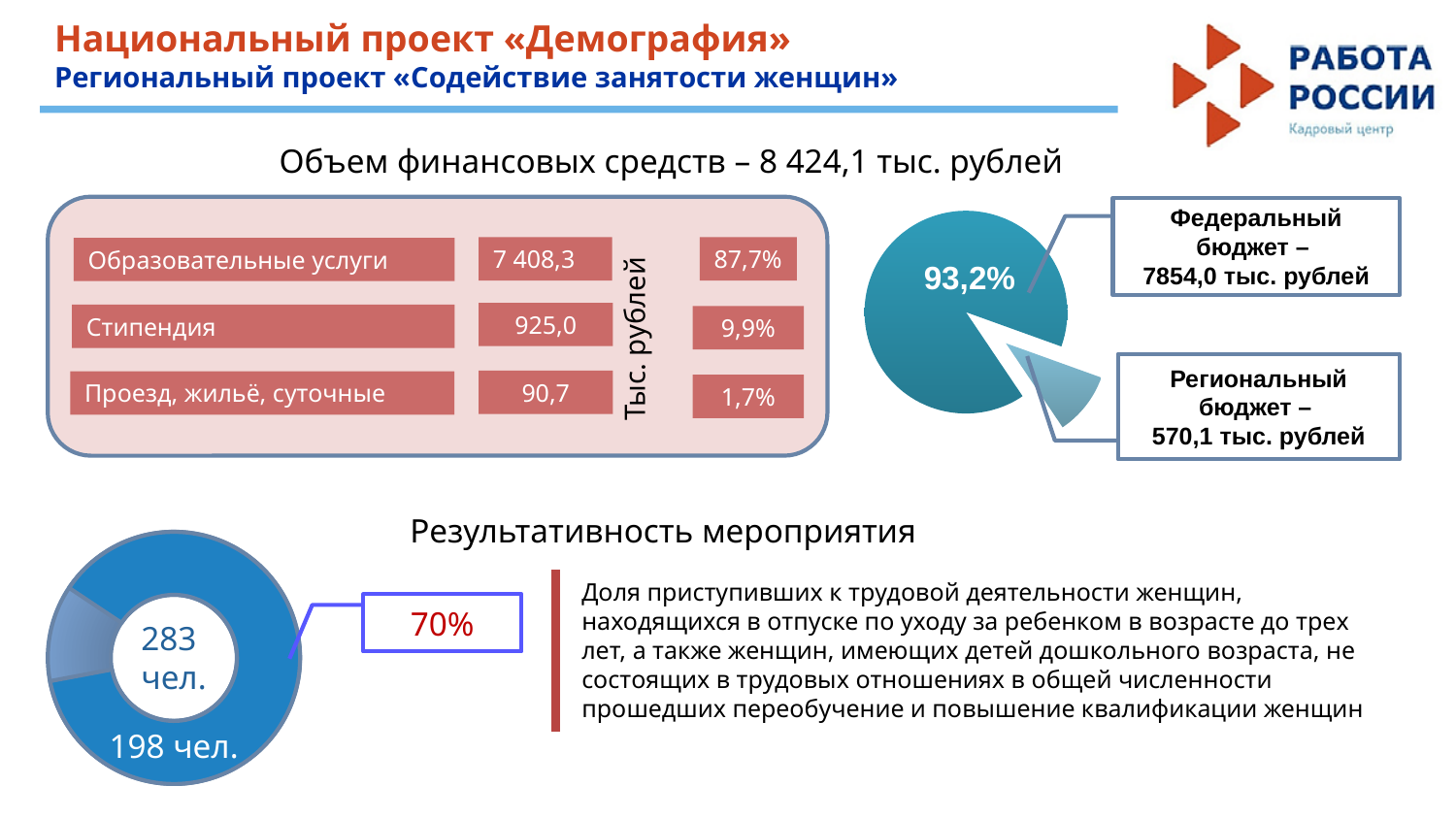
In the bottom-left doughnut chart, what value is printed on the large segment? 198 чел. How many segments does the bottom-left doughnut chart have? 2 In the top-right pie chart, what amount is given for the Региональный бюджет? 570,1 тыс. рублей In the top-right pie chart, what percentage is printed on the large slice? 93,2% In the bottom-left doughnut chart, what percentage is shown in the callout box pointing to the large segment? 70% What kind of chart is shown at the bottom left of the slide under «Результативность мероприятия»? Doughnut chart In the top-right pie chart, which budget is larger, Федеральный or Региональный? Федеральный бюджет How many slices does the top-right pie chart have? 2 In the top-right pie chart, what is the difference between the Федеральный бюджет and the Региональный бюджет? 7283,9 тыс. рублей In the top-right pie chart, what amount is given for the Федеральный бюджет? 7854,0 тыс. рублей What kind of chart is shown at the top right of the slide, next to the budget callouts? Pie chart In the bottom-left doughnut chart, what value is printed in the centre of the ring? 283 чел.